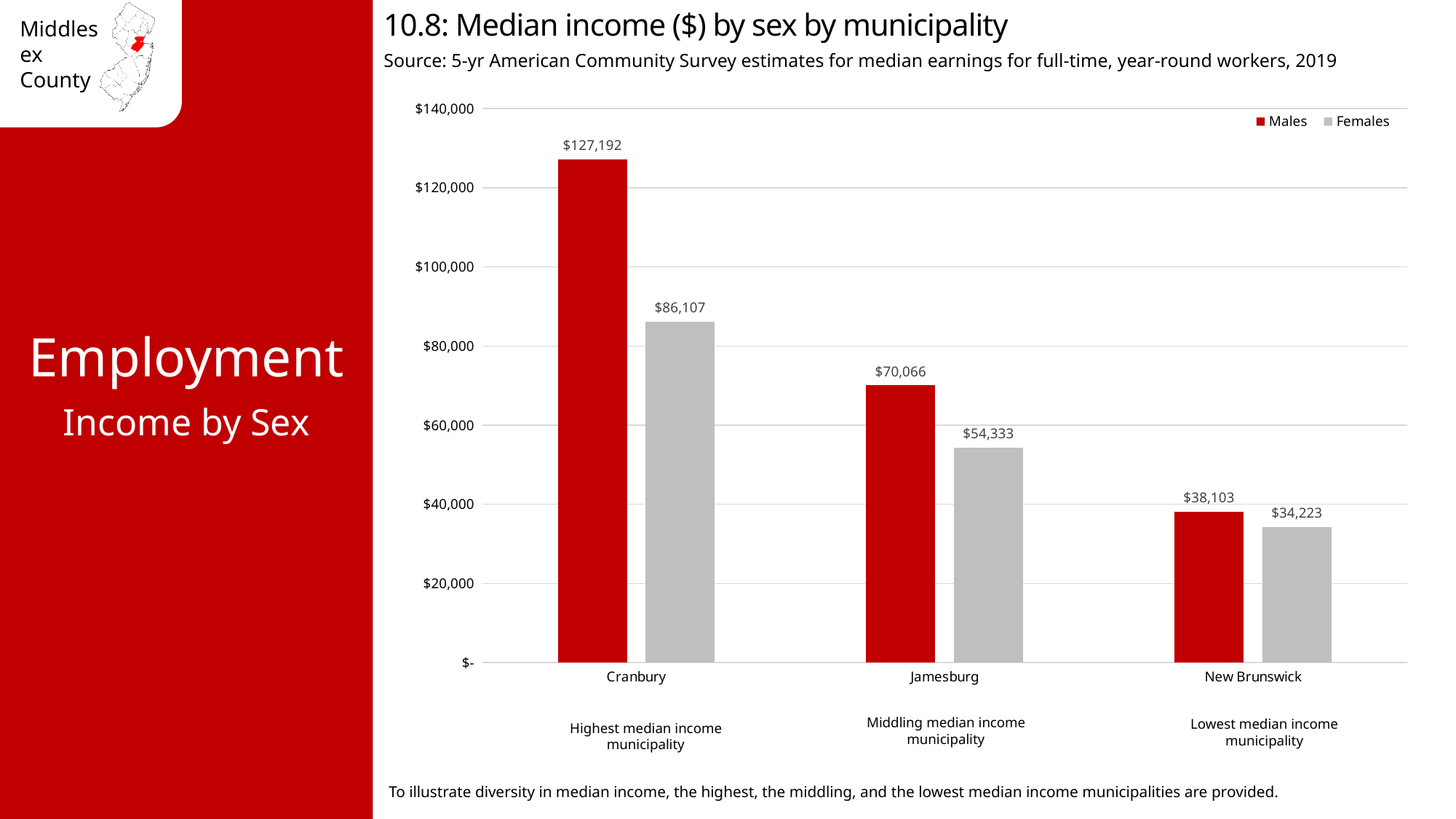
How many series does the legend list? 2 What is the difference between male and female median income in Cranbury? $41,085 What is the median income for females in Jamesburg? $54,333 Which municipality has the lowest median income for females? New Brunswick Which municipality has the highest median income for males? Cranbury How many municipalities are shown on the chart? 3 What kind of chart is shown on the slide? Bar chart Which is larger: the female median income in Cranbury or the male median income in Jamesburg? Female median income in Cranbury What is the median income for males in Cranbury? $127,192 What is the difference between male and female median income in New Brunswick? $3,880 Is the male median income in Jamesburg greater or less than $60,000? greater What is the median income for females in New Brunswick? $34,223